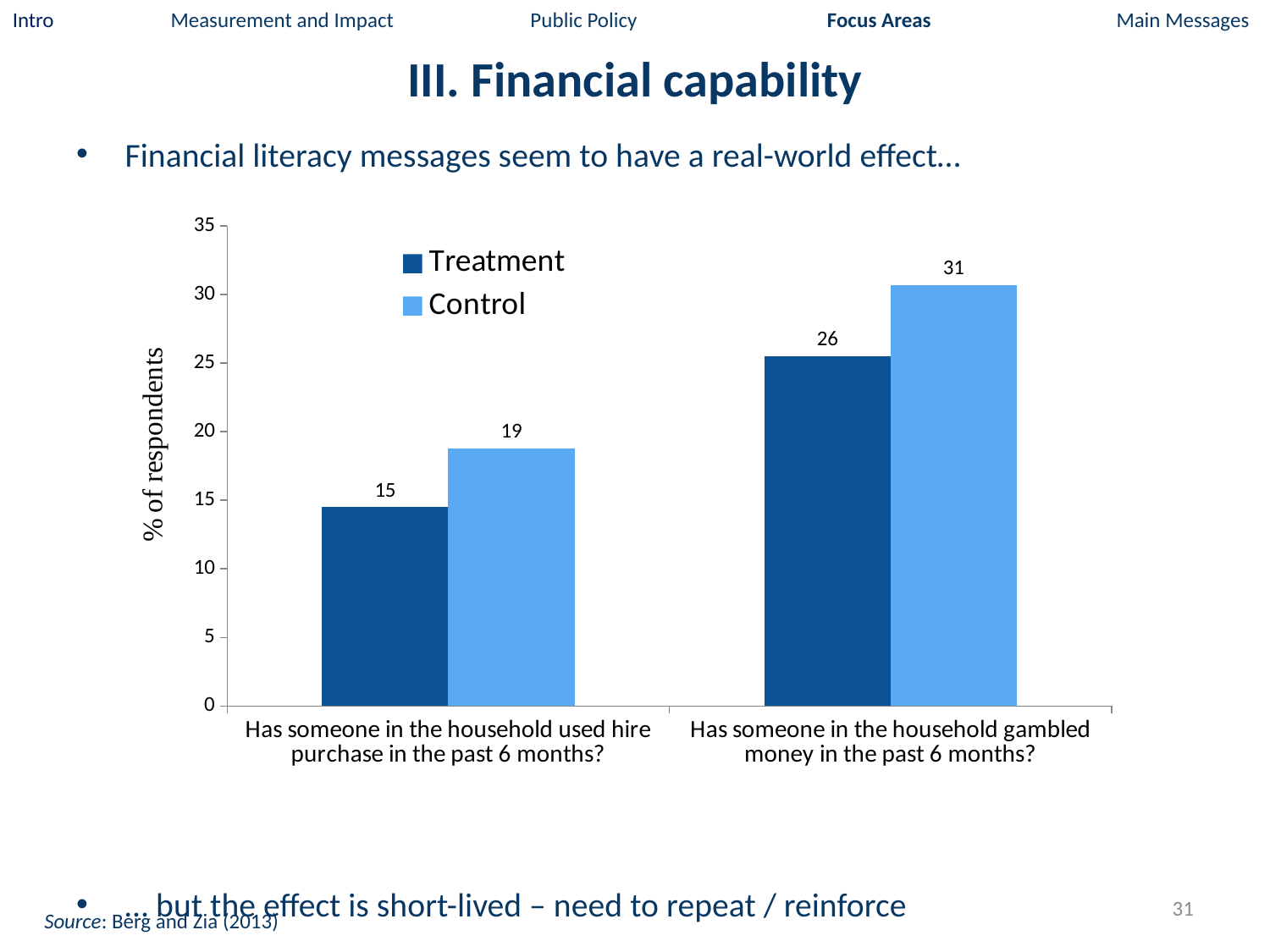
Which series has the highest value on the chart? Control For the hire purchase question, which is larger: Treatment or Control? Control What is the Treatment value for "Has someone in the household gambled money in the past 6 months?"? 26 What is the label of the y axis? % of respondents Which bar has the lowest value on the chart? Treatment for hire purchase What is the Treatment value for "Has someone in the household used hire purchase in the past 6 months?"? 15 What kind of chart is shown on the slide? Bar chart What is the Control value for "Has someone in the household used hire purchase in the past 6 months?"? 19 How many categories are shown on the x axis? 2 What is the difference between the Control and Treatment values for the gambling question? 5 How many series does the legend list? 2 What is the Control value for "Has someone in the household gambled money in the past 6 months?"? 31